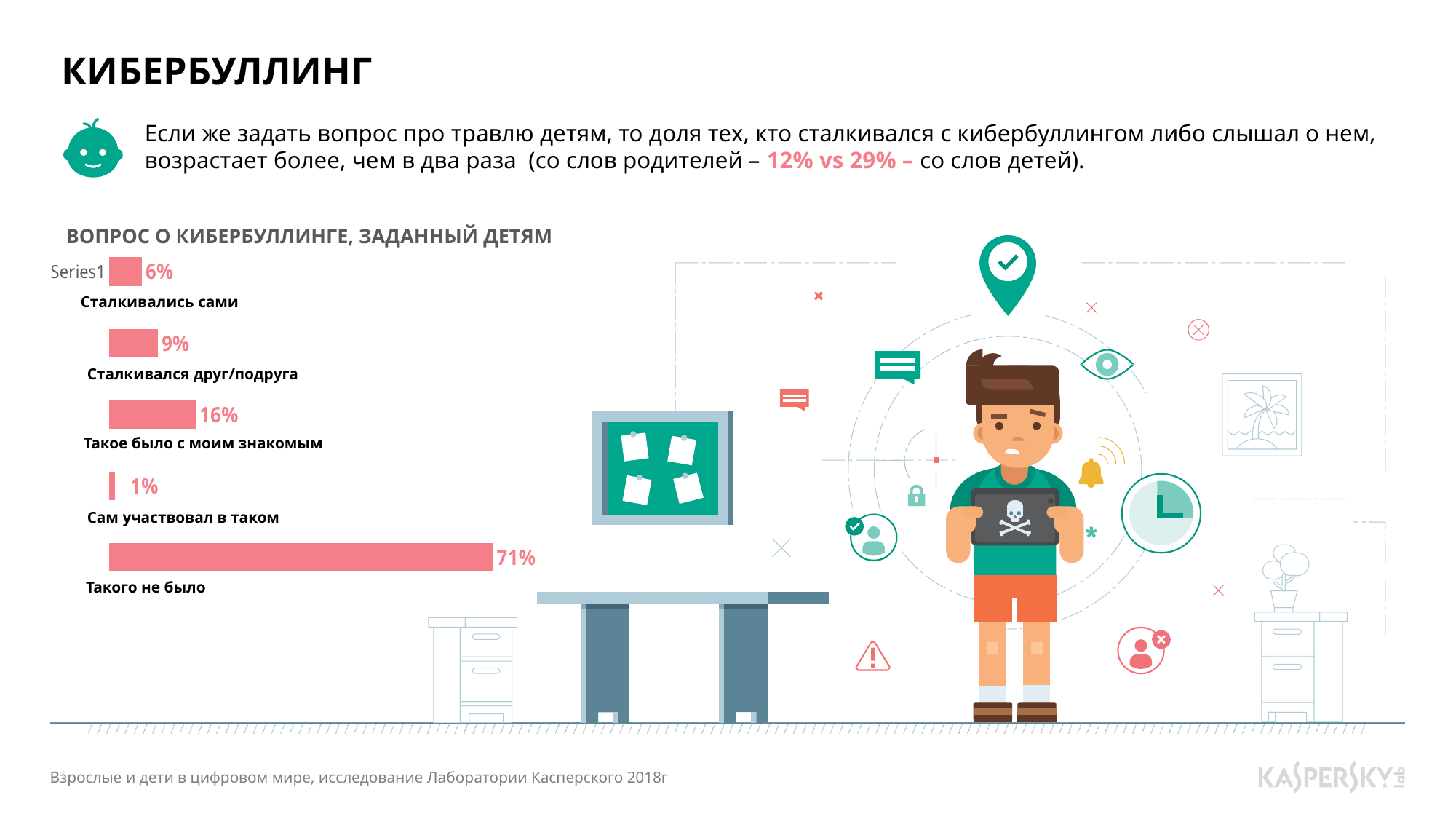
Which category has the highest value? Такого не было Which is larger: 'Сталкивался друг/подруга' or 'Сталкивались сами'? Сталкивался друг/подруга Which category has the lowest value? Сам участвовал в таком What is the title of the chart? ВОПРОС О КИБЕРБУЛЛИНГЕ, ЗАДАННЫЙ ДЕТЯМ What is the value for 'Сам участвовал в таком'? 1% What is the value for 'Сталкивался друг/подруга'? 9% What is the value for 'Такое было с моим знакомым'? 16% What is the difference between 'Такое было с моим знакомым' and 'Сталкивались сами'? 10% How many categories does the chart show? 5 What kind of chart is shown on the slide? bar chart What is the value for 'Такого не было'? 71% What is the value for 'Сталкивались сами'? 6%